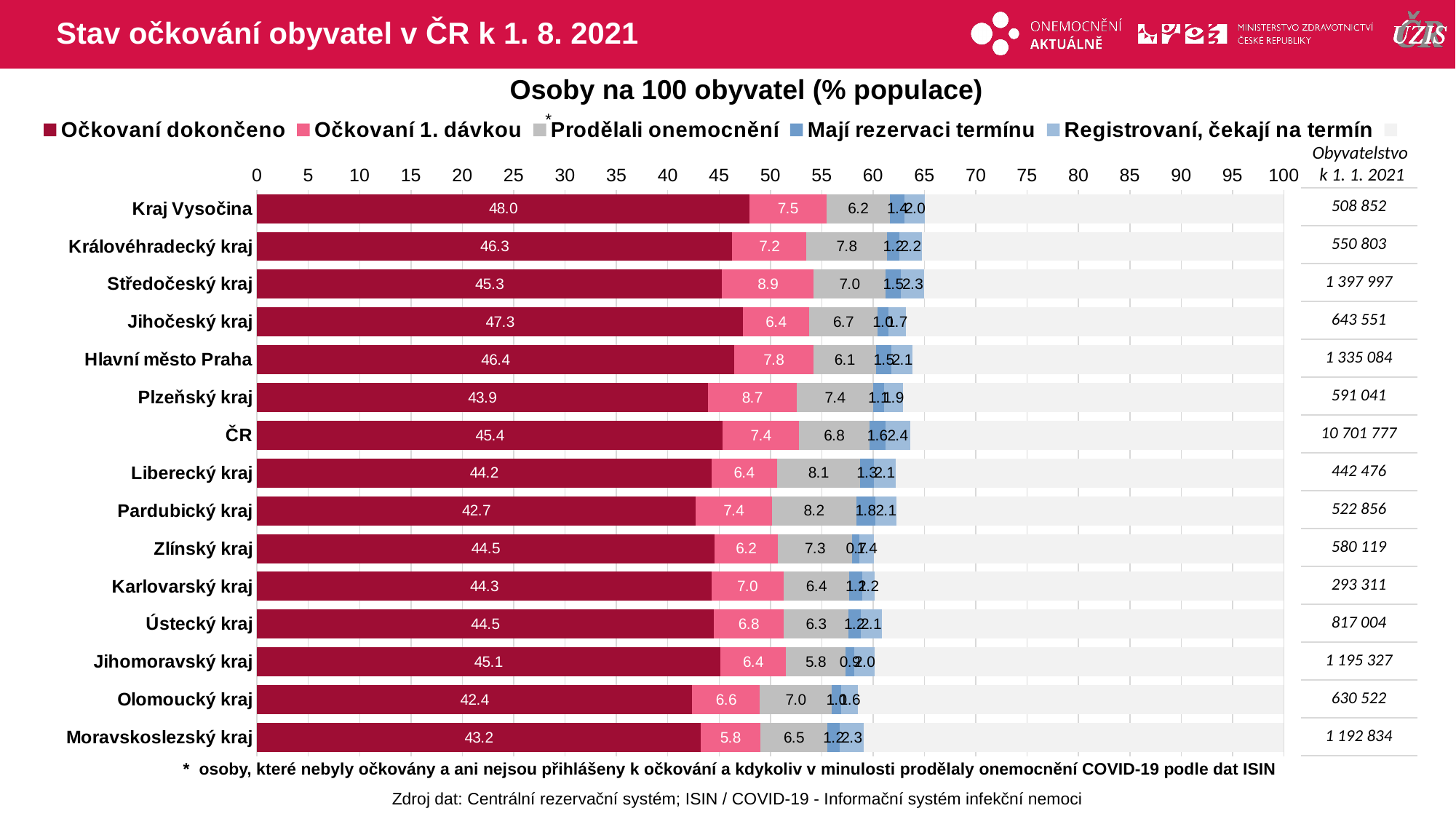
What type of chart is shown on the slide? Stacked bar chart What is the value of "Očkovaní dokončeno" for ČR? 45.4 What is the value of "Očkovaní dokončeno" for Kraj Vysočina? 48.0 Which has a larger value for "Očkovaní 1. dávkou": Plzeňský kraj or Jihočeský kraj? Plzeňský kraj Which region has the lowest value for "Očkovaní 1. dávkou"? Moravskoslezský kraj What is the difference in "Očkovaní dokončeno" between Kraj Vysočina and Olomoucký kraj? 5.6 What is the value of "Prodělali onemocnění" for Pardubický kraj? 8.2 Which region has the highest value for "Očkovaní dokončeno"? Kraj Vysočina How many categories (rows) are shown on the chart? 15 Is the value of "Očkovaní dokončeno" for Olomoucký kraj greater or less than 45? less Which region has the lowest value for "Očkovaní dokončeno"? Olomoucký kraj What is the value of "Očkovaní 1. dávkou" for Středočeský kraj? 8.9